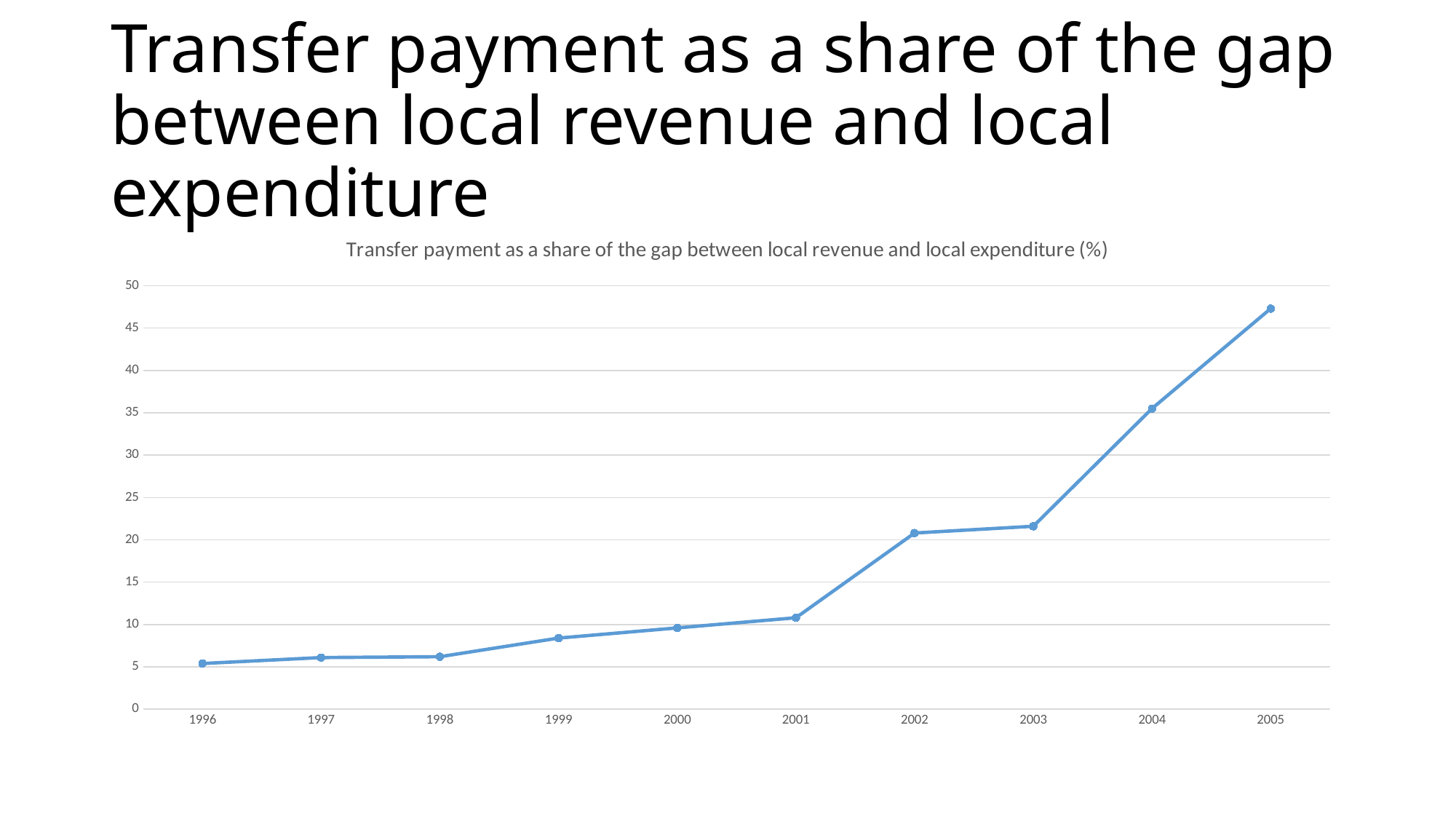
Is the value for 2005 greater or less than 45? greater Is the value for 2002 greater or less than 15? greater Which year has the larger value, 2003 or 2004? 2004 Is the value for 2004 greater or less than 30? greater What is the title printed above the chart's plot area? Transfer payment as a share of the gap between local revenue and local expenditure (%) Do the values generally rise or fall from 1996 to 2005? rise Which year has the highest transfer payment share? 2005 What kind of chart is shown on the slide? line chart How many years are plotted on the x axis of the chart? 10 Which year has the lowest transfer payment share? 1996